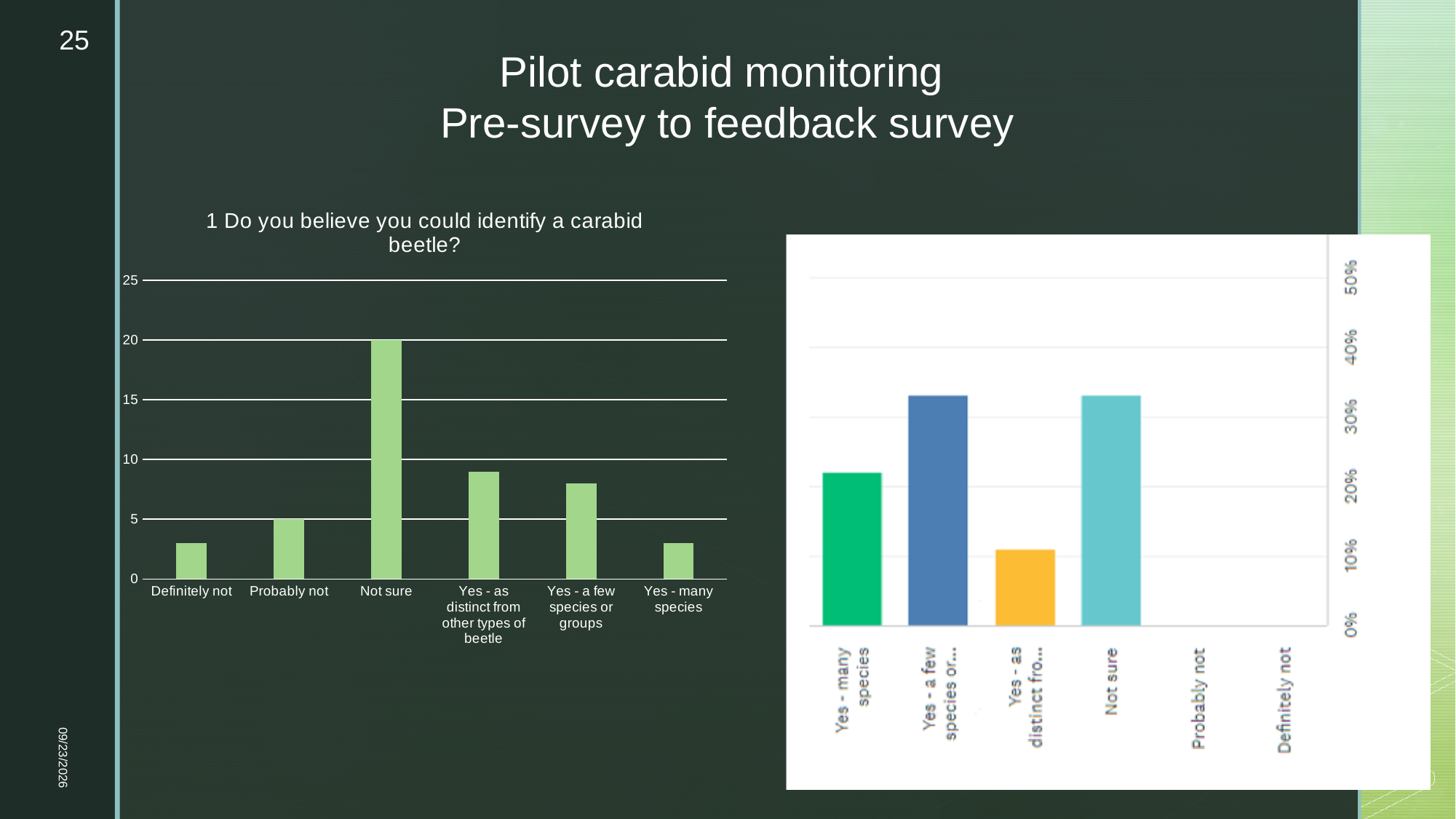
In the left chart titled '1 Do you believe you could identify a carabid beetle?', which category has the highest value? Not sure In the right chart, is the value for 'Yes - as distinct fro...' greater or less than 20%? less In the left chart titled '1 Do you believe you could identify a carabid beetle?', what is the value for 'Not sure'? 20 In the right chart, is the value for 'Yes - many species' greater or less than 20%? greater In the left chart titled '1 Do you believe you could identify a carabid beetle?', is the value for 'Yes - as distinct from other types of beetle' greater or less than 10? less How many categories are shown on the x axis of the left chart titled '1 Do you believe you could identify a carabid beetle?'? 6 In the left chart titled '1 Do you believe you could identify a carabid beetle?', which is larger: the value for 'Not sure' or the value for 'Yes - a few species or groups'? Not sure In the left chart titled '1 Do you believe you could identify a carabid beetle?', what is the value for 'Probably not'? 5 In the left chart titled '1 Do you believe you could identify a carabid beetle?', what is the difference between the values for 'Not sure' and 'Probably not'? 15 In the right chart, which is larger: the value for 'Not sure' or the value for 'Yes - many species'? Not sure What kind of chart is the left chart titled '1 Do you believe you could identify a carabid beetle?'? bar chart